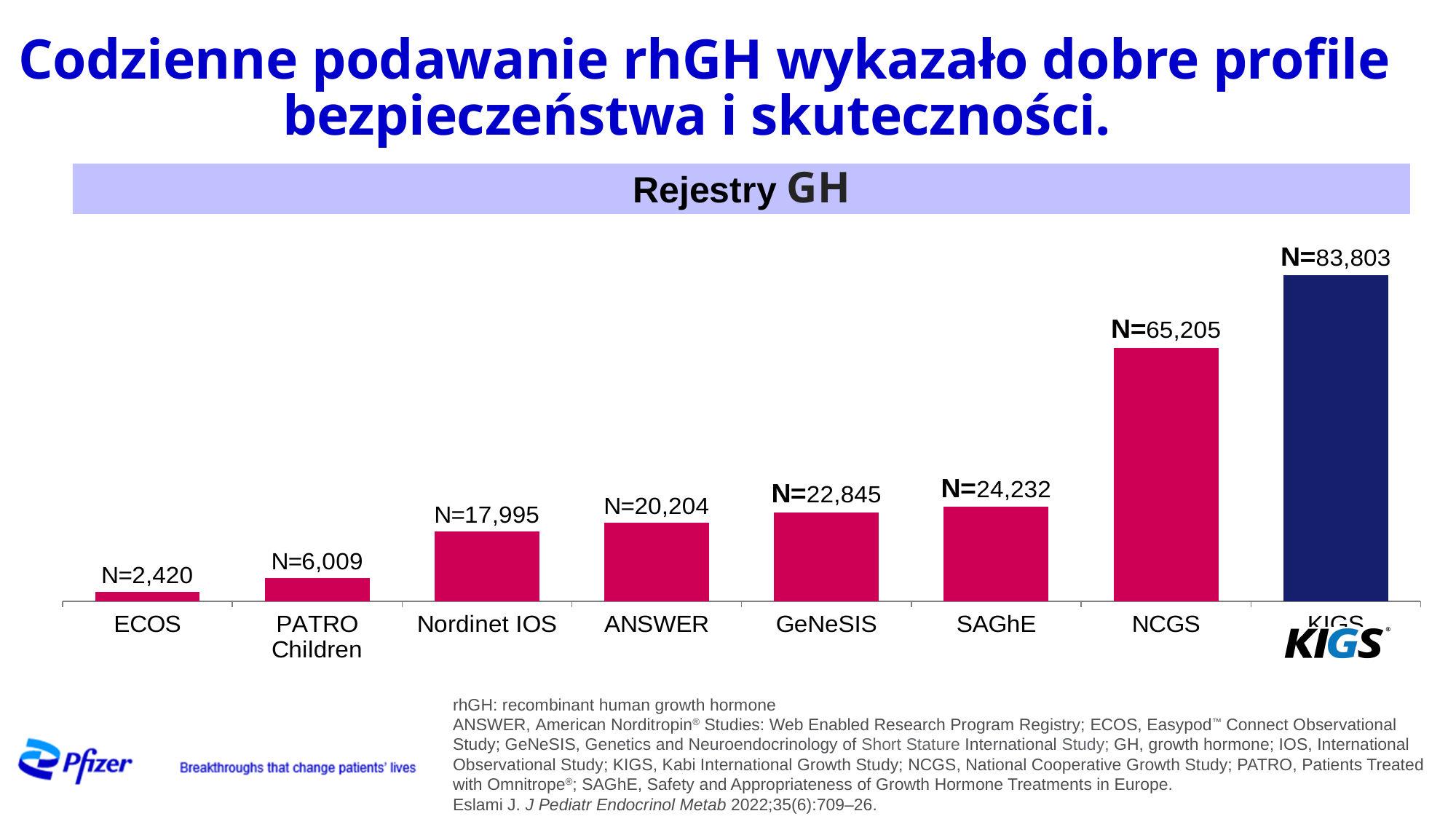
What is the N value for the KIGS registry? N=83,803 Which registry has the lowest N? ECOS Which registry has the highest N? KIGS What is the N value for the SAGhE registry? N=24,232 How many registries are shown in the chart? 8 Which registry has a larger N, GeNeSIS or ANSWER? GeNeSIS What is the title of the chart? Rejestry GH What is the difference in N between KIGS and NCGS? 18,598 What is the difference in N between PATRO Children and ECOS? 3,589 What is the N value for the Nordinet IOS registry? N=17,995 What is the N value for the ECOS registry? N=2,420 What type of chart is shown on the slide? Bar chart